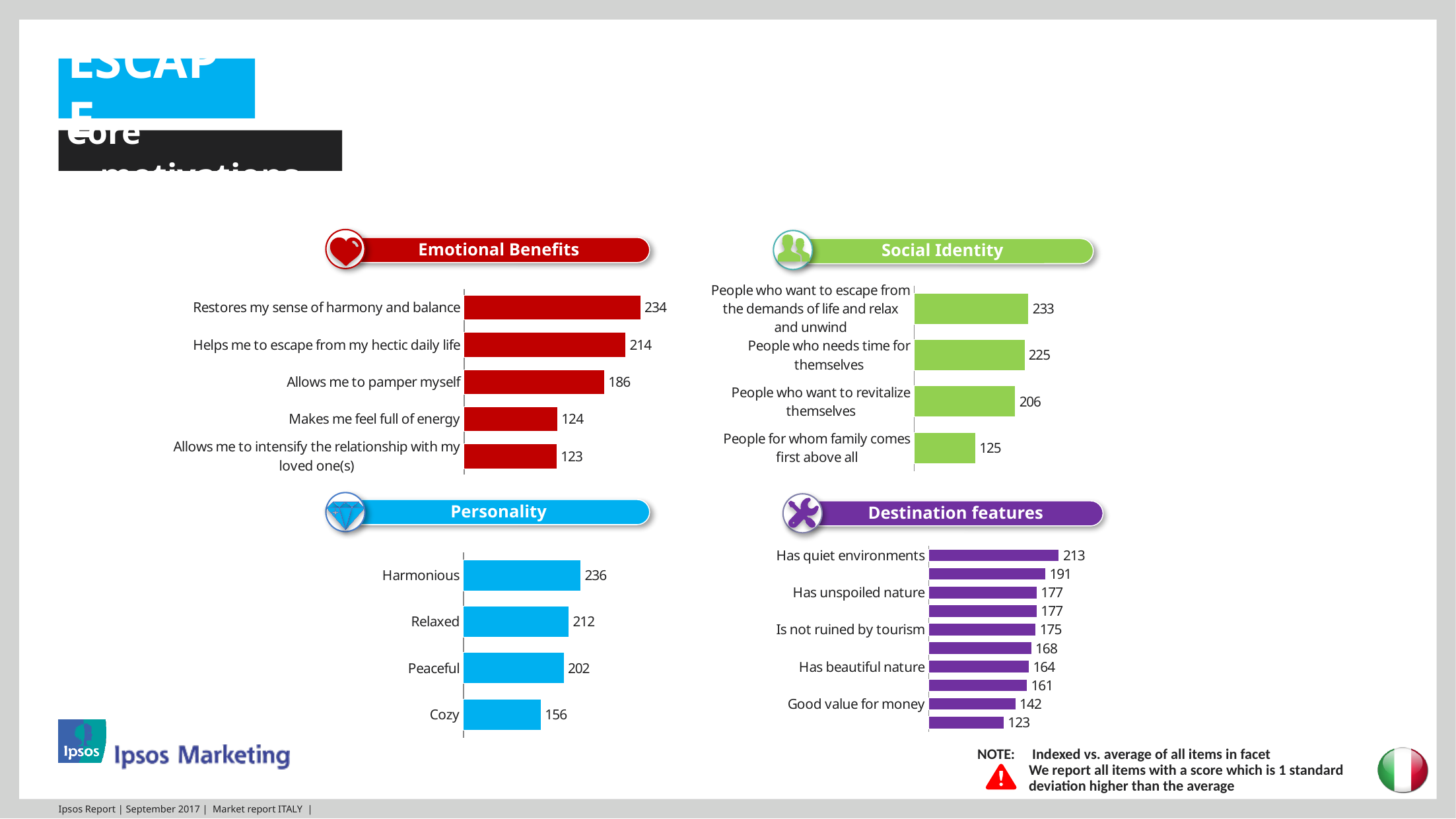
In the Social Identity chart, which category has the lowest value? People for whom family comes first above all In the Emotional Benefits chart, what is the value for "Allows me to pamper myself"? 186 In the Social Identity chart, what is the difference between "People who want to revitalize themselves" and "People for whom family comes first above all"? 81 In the Destination features chart, what is the value for "Has quiet environments"? 213 In the Social Identity chart, what is the value for "People who needs time for themselves"? 225 What kind of chart is the Personality chart? Bar chart In the Emotional Benefits chart, what is the difference between "Restores my sense of harmony and balance" and "Helps me to escape from my hectic daily life"? 20 How many categories are shown in the Emotional Benefits chart? 5 In the Emotional Benefits chart, which category has the highest value? Restores my sense of harmony and balance In the Destination features chart, what is the difference between "Has unspoiled nature" and "Good value for money"? 35 In the Personality chart, which is larger, "Relaxed" or "Cozy"? Relaxed In the Personality chart, what is the value for "Peaceful"? 202